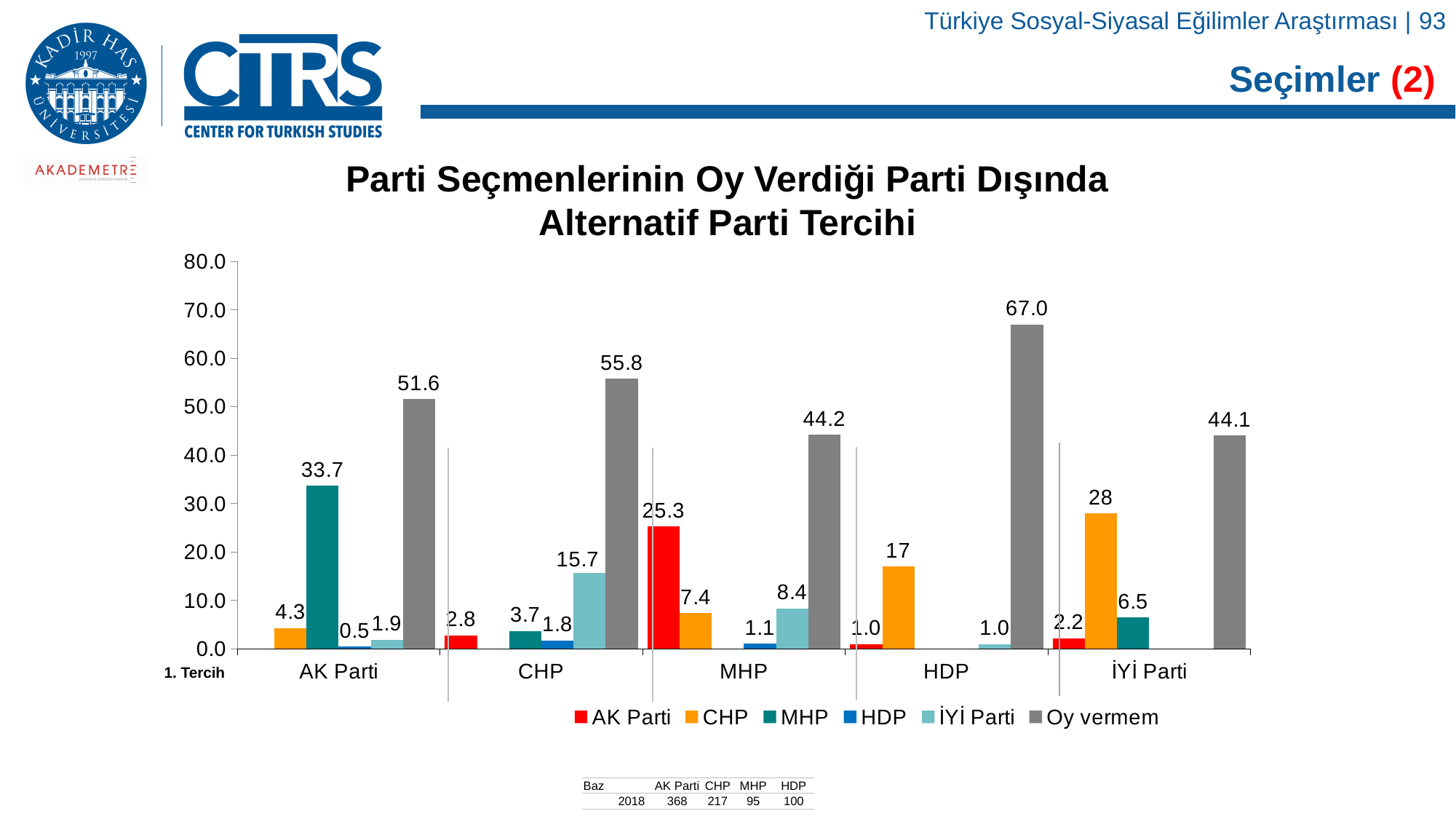
What is the difference between the Oy vermem values for the CHP and AK Parti categories? 4.2 Which category has the highest value for the Oy vermem series? HDP What is the value of the MHP series for the AK Parti category? 33.7 Which series has the lowest value in the AK Parti category? HDP What is the difference between the CHP series values for the İYİ Parti and HDP categories? 11 What is the value of the Oy vermem series for the HDP category? 67.0 What kind of chart is shown on the slide? Bar chart What is the value of the AK Parti series for the MHP category? 25.3 How many categories are shown on the x axis? 5 How many series does the legend list? 6 Is the CHP series value larger for the İYİ Parti category or the HDP category? İYİ Parti What is the value of the İYİ Parti series for the CHP category? 15.7